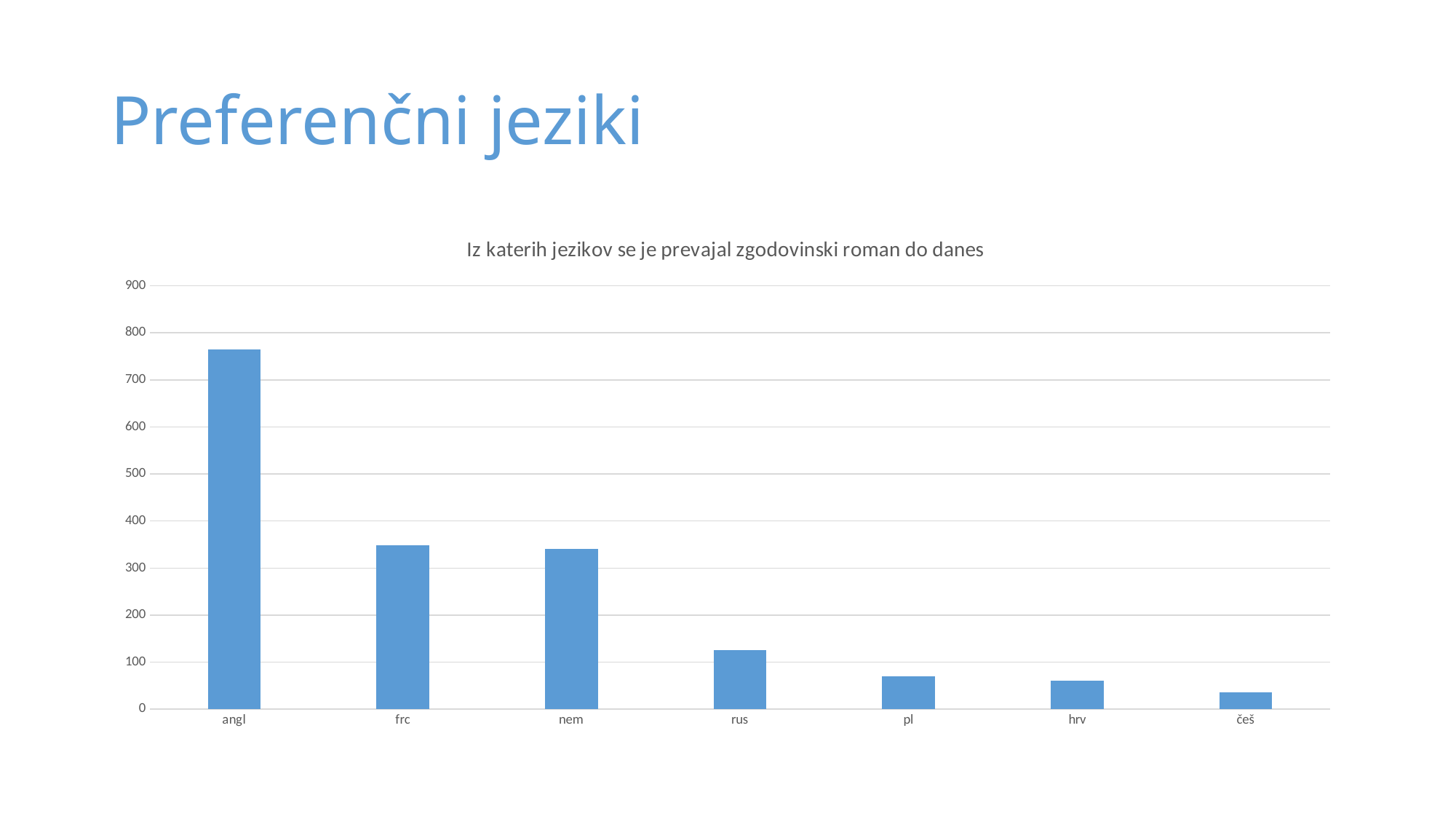
Is the value for angl greater or less than 700? greater Is the value for rus greater or less than 200? less What is the title of the chart? Iz katerih jezikov se je prevajal zgodovinski roman do danes How many categories are shown on the x axis of the chart? 7 Which category has the lowest value in the chart? češ Is the value for frc greater or less than 400? less What kind of chart is shown on the slide? bar chart Which is larger, the value for angl or the value for frc? angl Do the values rise or fall from left to right along the x axis? fall Which category has the highest value in the chart? angl